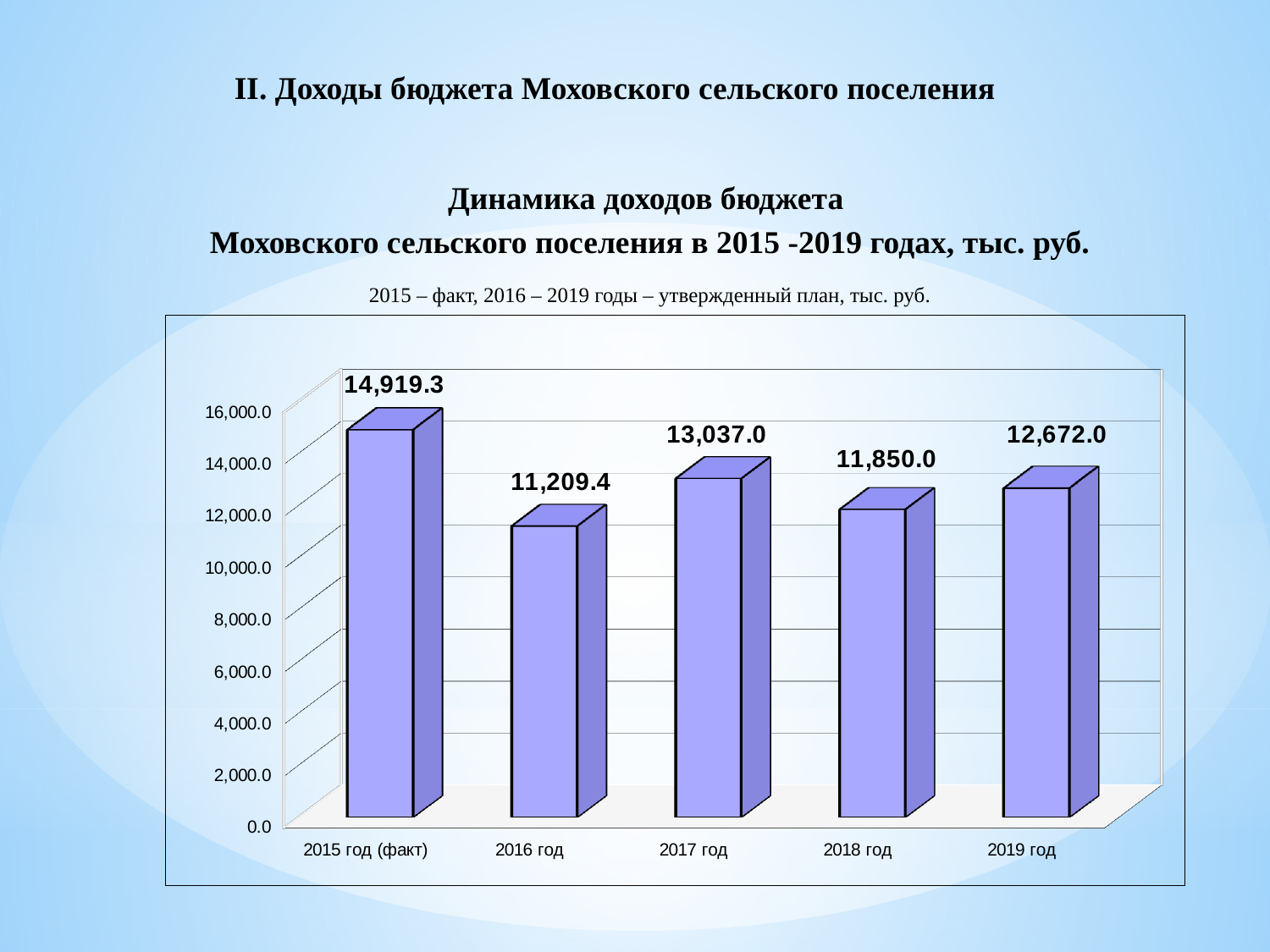
Which is larger, the value for 2017 год or the value for 2019 год? 2017 год Which year has the highest budget revenue value? 2015 год (факт) What is the value shown for 2017 год? 13,037.0 What is the difference between the values for 2017 год and 2018 год? 1,187.0 In what units are the values on the chart expressed, according to the chart title? тыс. руб. What is the value shown for 2019 год? 12,672.0 What kind of chart is shown on the slide? bar chart What is the budget revenue value shown for 2015 год (факт)? 14,919.3 What is the difference between the values for 2015 год (факт) and 2016 год? 3,709.9 Which year has the lowest budget revenue value? 2016 год How many years (categories) are shown on the chart? 5 Is the value for 2018 год greater or less than 12,000.0? less